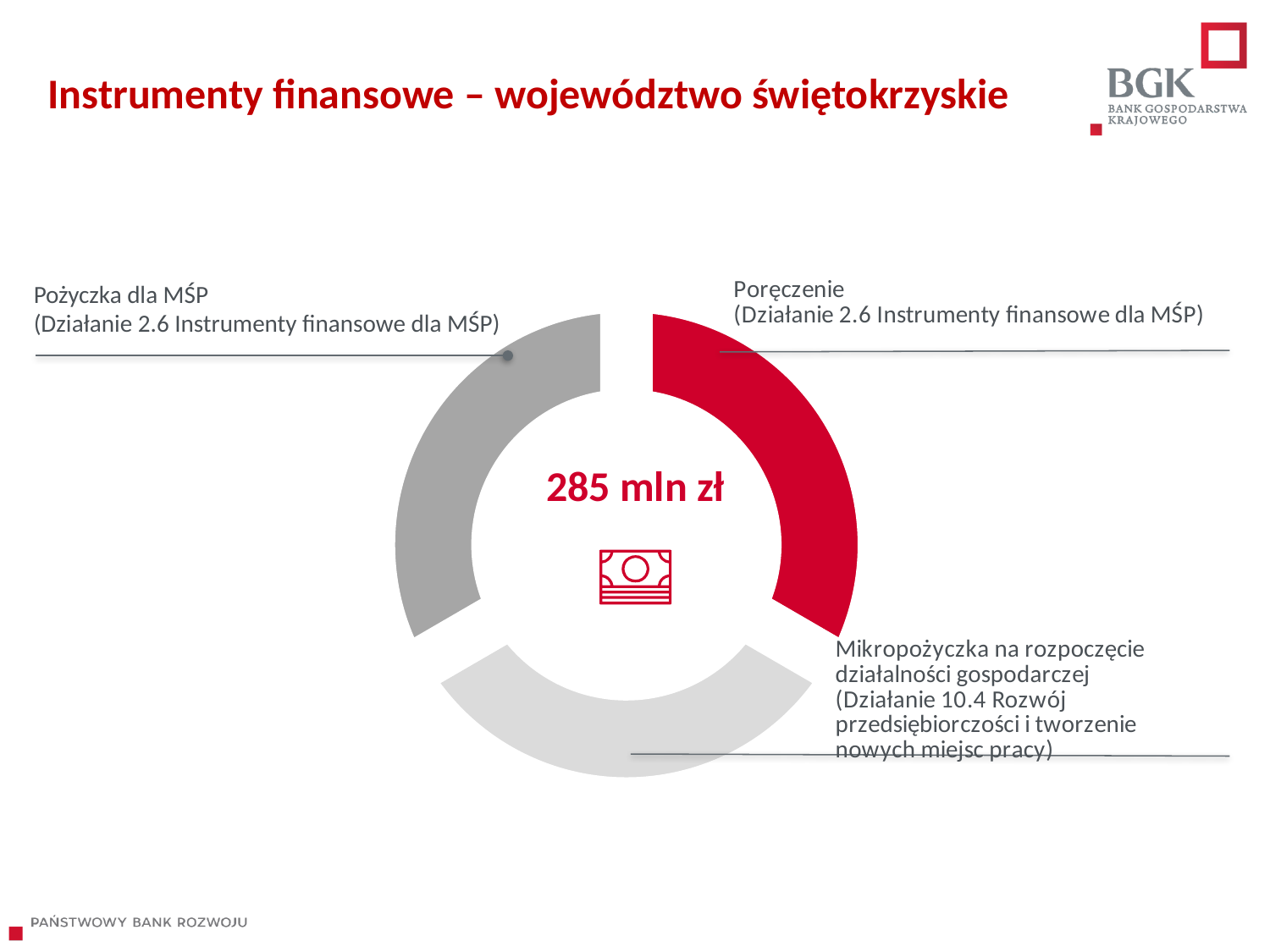
What kind of chart is shown on the slide? donut chart What colour is the segment labelled Poręczenie in the donut chart? red What total value is printed in the centre of the donut chart? 285 mln zł How many segments does the donut chart have? 3 What is the title of the slide containing the donut chart? Instrumenty finansowe – województwo świętokrzyskie